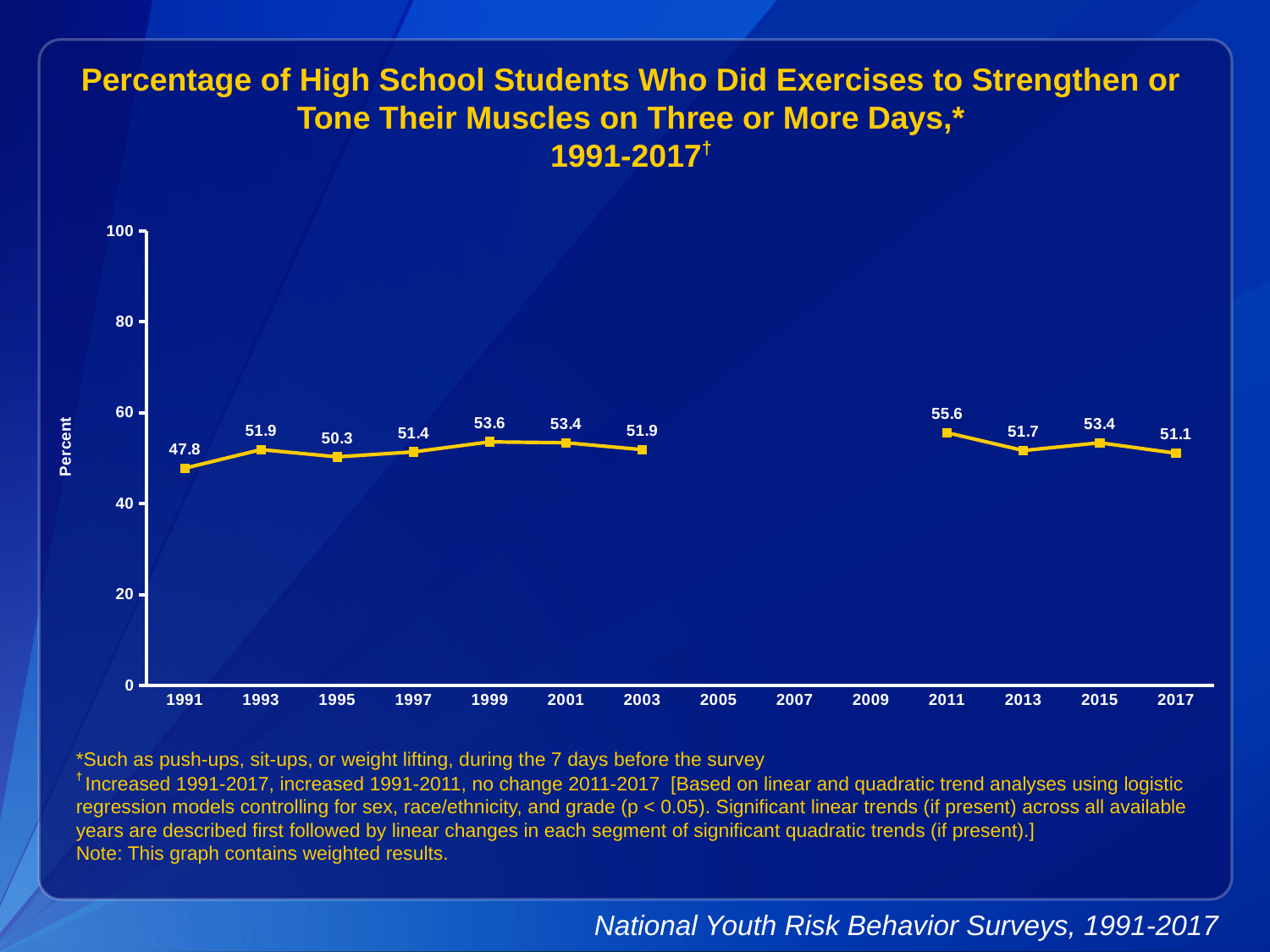
Which year has a larger value, 1995 or 1999? 1999 How many data points are plotted on the chart? 11 What percentage of high school students did exercises to strengthen or tone their muscles on three or more days in 1991? 47.8 Which year has the highest value on the chart? 2011 What is the value plotted for 1999? 53.6 What type of chart is shown on the slide? Line chart What is the difference between the values for 2011 and 2017? 4.5 What is the difference between the values for 1993 and 1991? 4.1 What is the value plotted for 2011? 55.6 What is the label on the vertical axis of the chart? Percent What is the value plotted for 2017? 51.1 Which year has the lowest value on the chart? 1991